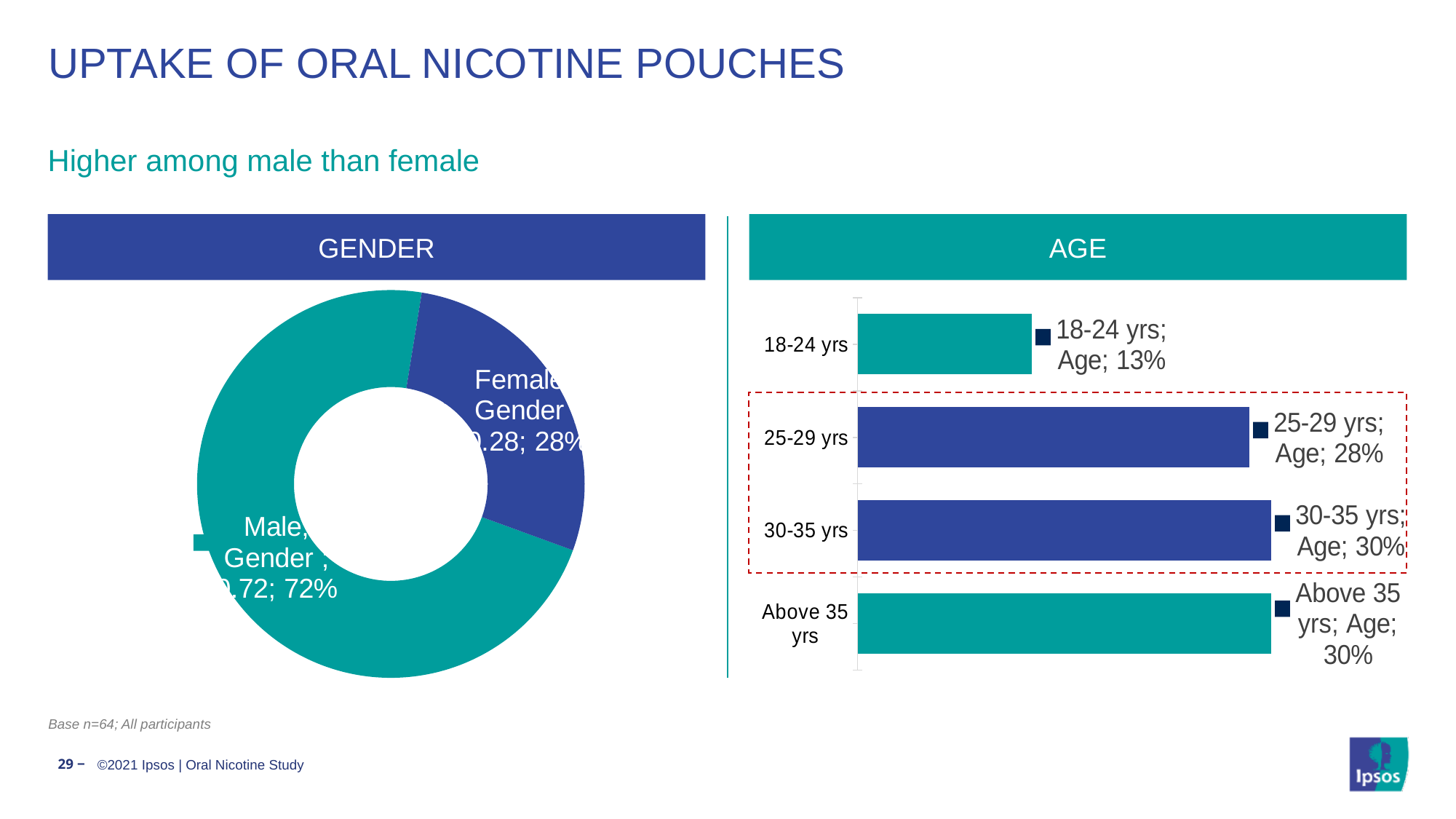
What kind of chart is the GENDER chart? Donut (pie) chart In the GENDER chart, what share of uptake is Male? 72% In the GENDER chart, which category has the larger share, Male or Female? Male In the GENDER chart, what share of uptake is Female? 28% In the GENDER chart, what is the difference in percentage points between Male and Female? 44 percentage points In the AGE chart, what is the value for Above 35 yrs? 30% In the AGE chart, what is the value for 18-24 yrs? 13% In the AGE chart, what is the value for 25-29 yrs? 28% What kind of chart is the AGE chart? Bar chart In the AGE chart, what is the difference in percentage points between 30-35 yrs and 18-24 yrs? 17 percentage points In the AGE chart, how many age groups are shown? 4 In the AGE chart, which age group has the lowest value? 18-24 yrs